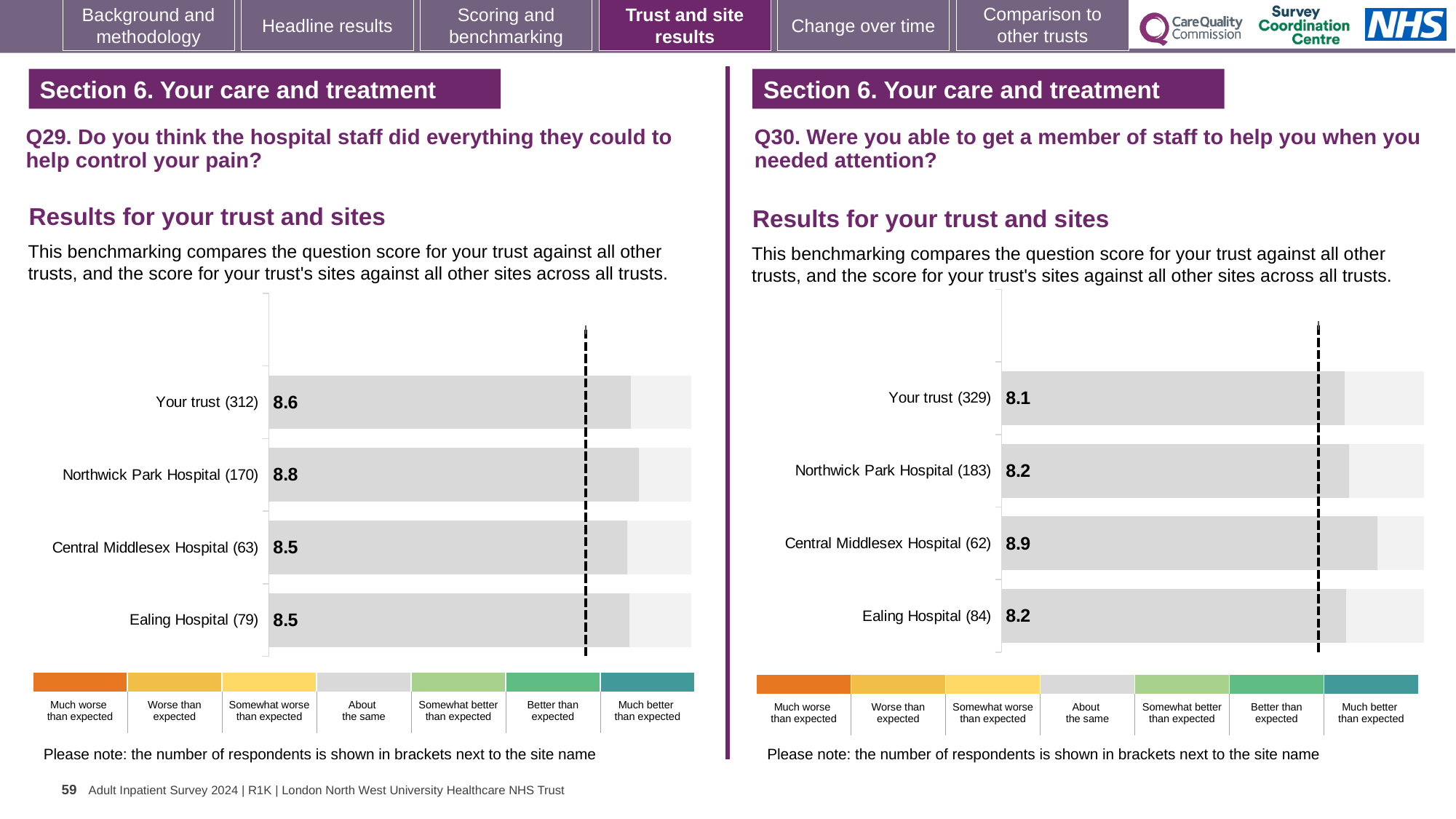
What type of chart is used for the Q29 results on the left? Bar chart In the Q30 chart on the right, which site or trust has the lowest score? Your trust (329) In the Q29 chart on the left, what is the score for Northwick Park Hospital (170)? 8.8 In the Q30 chart on the right, how many respondents are shown in brackets for Your trust? 329 In the Q30 chart on the right, which has the higher score: Central Middlesex Hospital (62) or Northwick Park Hospital (183)? Central Middlesex Hospital (62) In the Q29 chart on the left, what is the score for Your trust (312)? 8.6 In the Q29 chart on the left, how many bars are plotted? 4 In the Q29 chart on the left, what is the difference between the scores for Northwick Park Hospital (170) and Ealing Hospital (79)? 0.3 In the Q30 chart on the right, what is the score for Central Middlesex Hospital (62)? 8.9 In the Q30 chart on the right, what is the difference between the scores for Central Middlesex Hospital (62) and Your trust (329)? 0.8 In the Q29 chart on the left, which site or trust has the highest score? Northwick Park Hospital (170) In the Q30 chart on the right, what is the score for Ealing Hospital (84)? 8.2